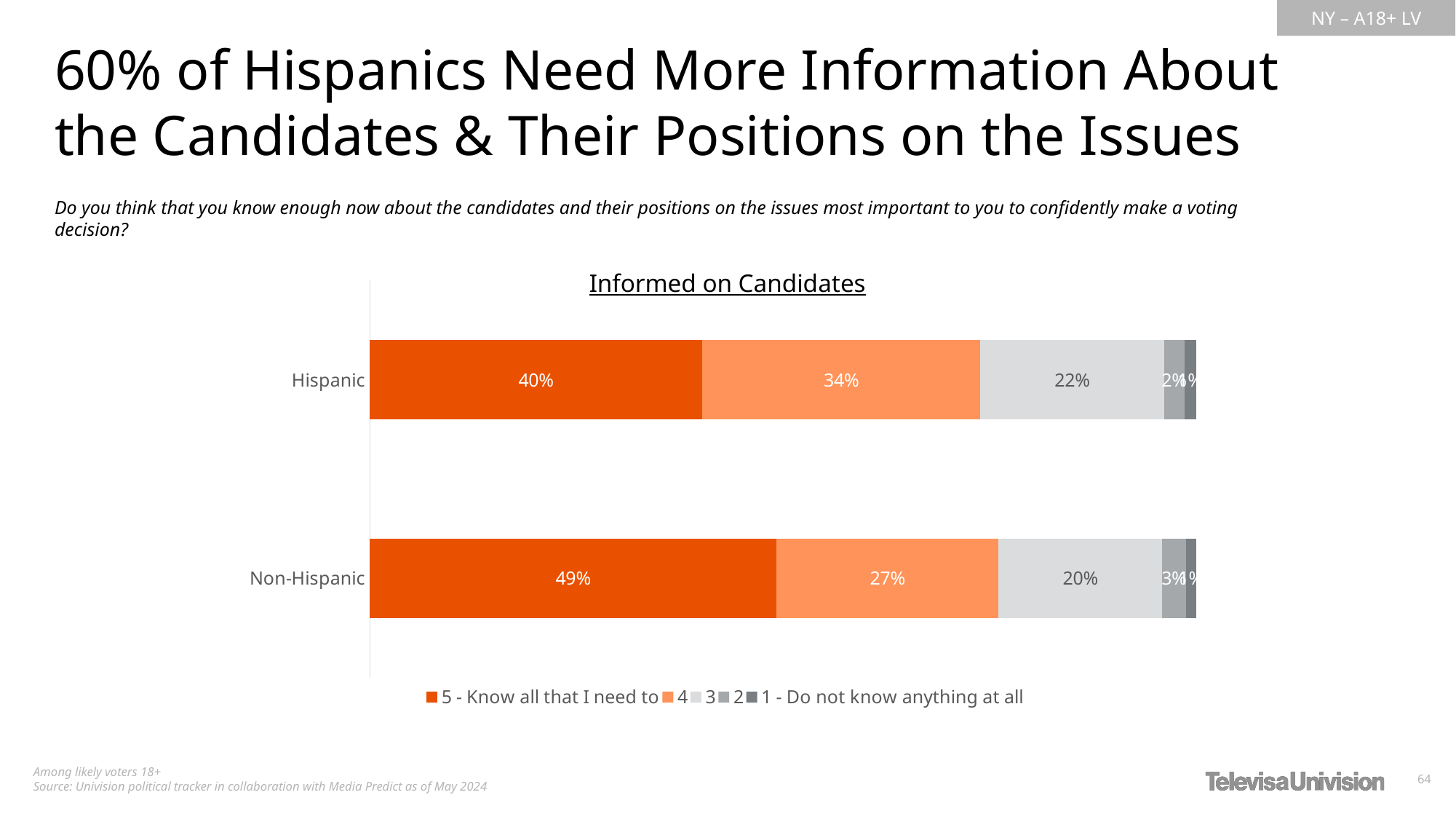
In the Informed on Candidates chart, what is the value of the "4" segment for Non-Hispanic respondents? 27% In the Informed on Candidates chart, what is the value of the "3" segment for Non-Hispanic respondents? 20% In the Informed on Candidates chart, which response category is the largest segment of the Hispanic bar? 5 - Know all that I need to What type of chart is used to show the Informed on Candidates data? Stacked bar chart In the Informed on Candidates chart, what is the value of the "3" segment for Hispanic respondents? 22% In the Informed on Candidates chart, which group has the larger "4" segment, Hispanic or Non-Hispanic? Hispanic How many series does the legend of the Informed on Candidates chart list? 5 In the Informed on Candidates chart, what is the value of the "4" segment for Hispanic respondents? 34% In the Informed on Candidates chart, what percentage of Hispanic respondents answered "5 - Know all that I need to"? 40% In the Informed on Candidates chart, how many percentage points higher is the "5 - Know all that I need to" share for Non-Hispanic respondents than for Hispanic respondents? 9 percentage points How many groups (bars) are shown in the Informed on Candidates chart? 2 In the Informed on Candidates chart, what percentage of Non-Hispanic respondents answered "5 - Know all that I need to"? 49%